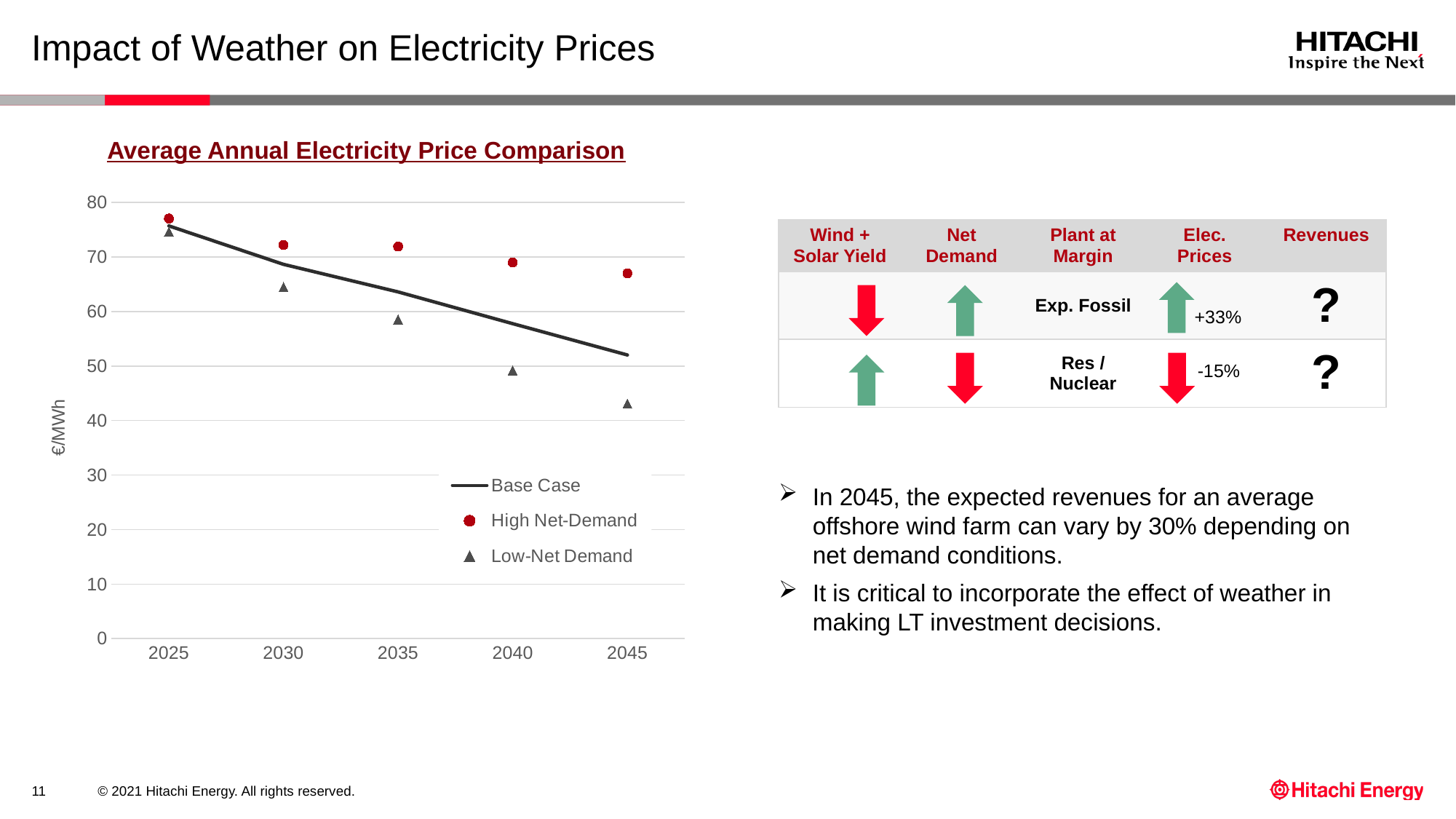
What is the title of the chart on the slide? Average Annual Electricity Price Comparison What kind of chart is shown on the slide? line chart In which year is the Low-Net Demand value lowest? 2045 Is the Low-Net Demand value for 2045 greater or less than 50? less Is the High Net-Demand value for 2045 greater or less than 60? greater What unit is shown on the y-axis of the chart? €/MWh Is the Low-Net Demand value for 2030 greater or less than 60? greater In 2045, which is larger: the High Net-Demand value or the Low-Net Demand value? High Net-Demand Does the Base Case line rise or fall from 2025 to 2045? fall How many series does the chart legend list? 3 How many years are shown on the x-axis of the chart? 5